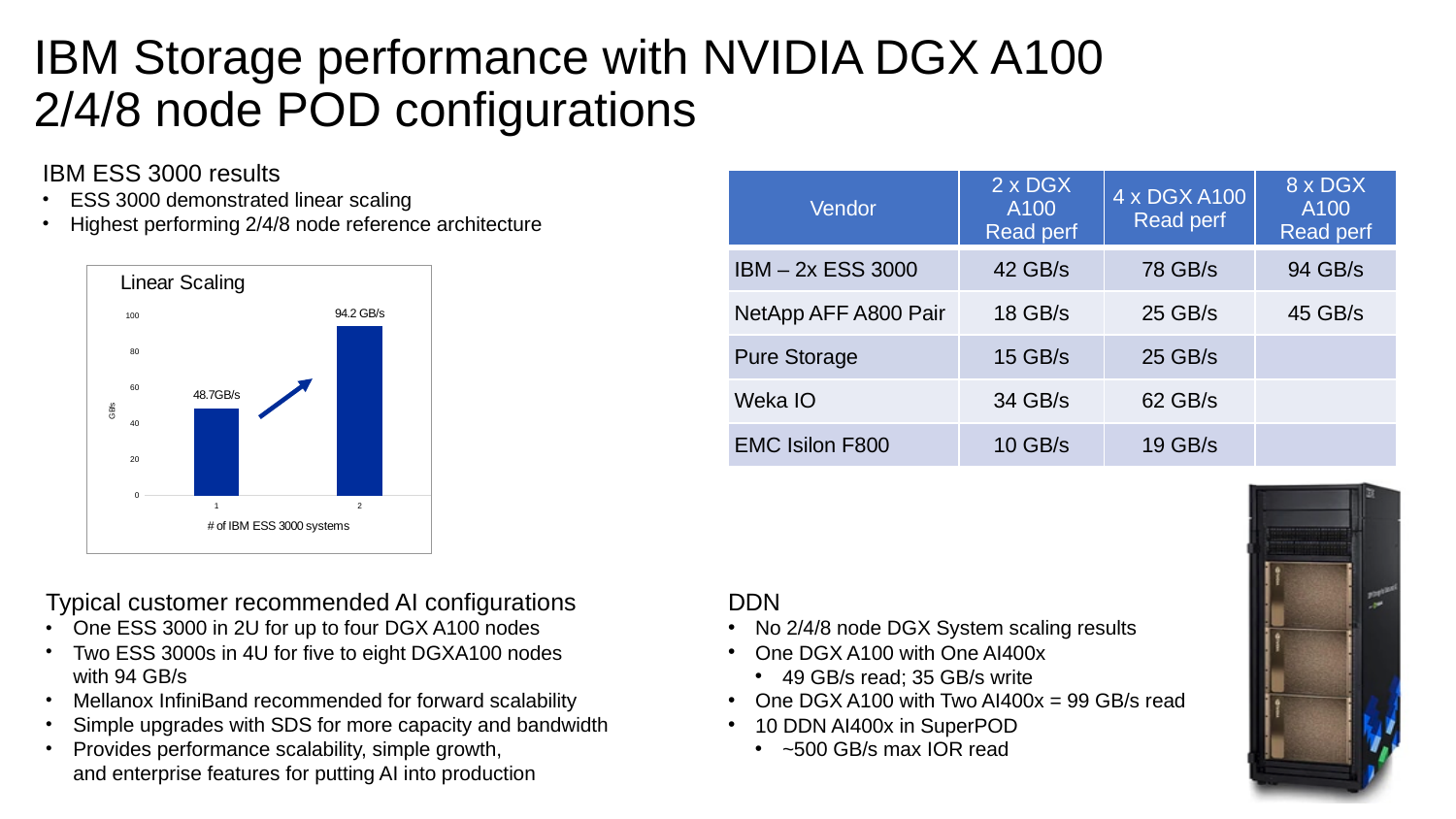
In the Linear Scaling chart, is the value for 1 IBM ESS 3000 system greater or less than 60? less In the Linear Scaling chart, do the values rise or fall as the number of IBM ESS 3000 systems increases? rise In the Linear Scaling chart, what is the difference between the value for 2 systems and the value for 1 system? 45.5 GB/s In the Linear Scaling chart, which number of IBM ESS 3000 systems has the lowest value? 1 In the Linear Scaling chart, which is larger: the value for 1 system or the value for 2 systems? 2 systems In the Linear Scaling chart, what is the value for 2 IBM ESS 3000 systems? 94.2 GB/s In the Linear Scaling chart, which number of IBM ESS 3000 systems has the highest value? 2 In the Linear Scaling chart, is the value for 2 IBM ESS 3000 systems greater or less than 80? greater In the Linear Scaling chart, what is the value for 1 IBM ESS 3000 system? 48.7GB/s How many bars are plotted in the Linear Scaling chart? 2 What is the x-axis label of the Linear Scaling chart? # of IBM ESS 3000 systems What kind of chart is the Linear Scaling chart? bar chart